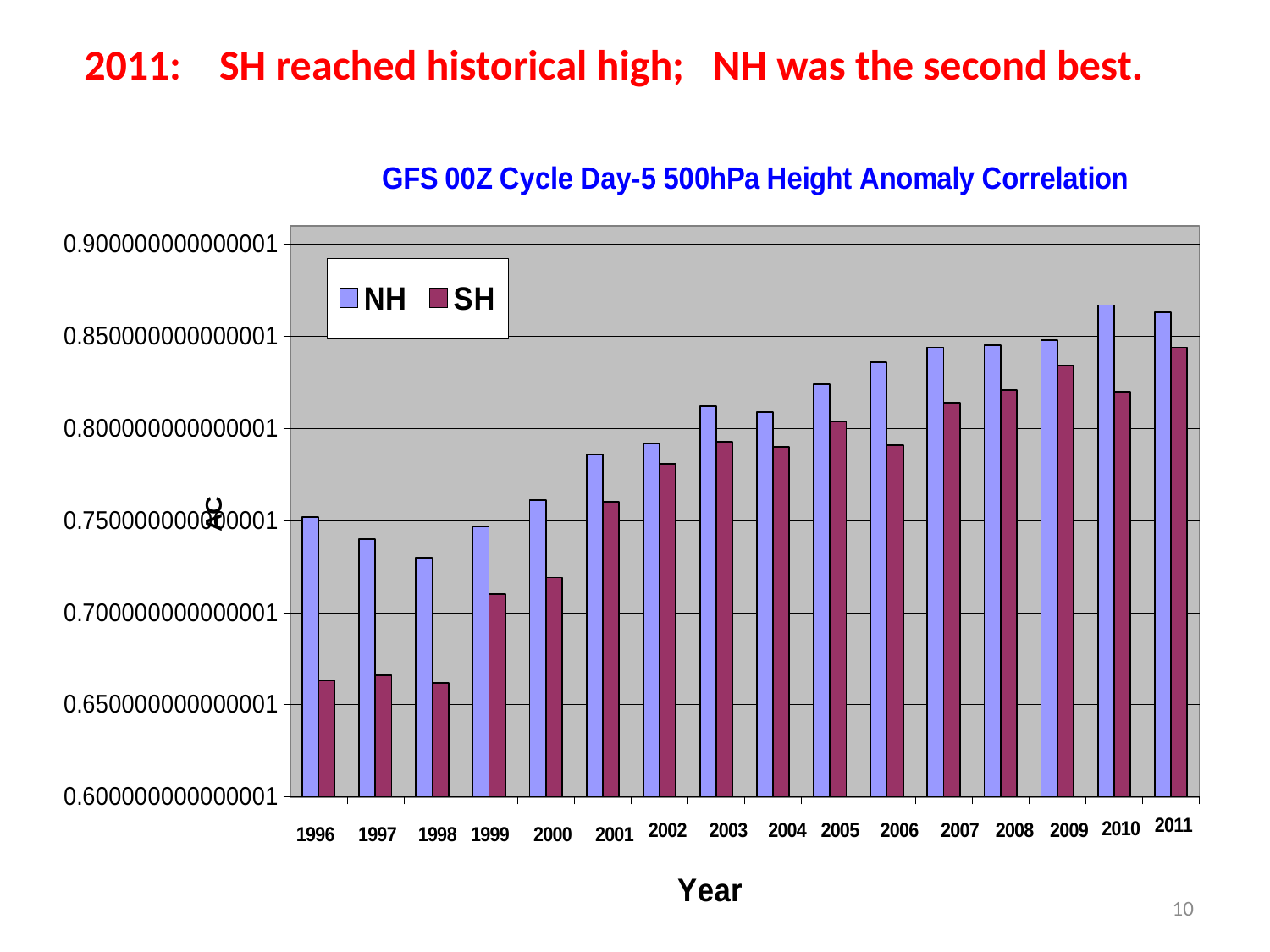
In which year is the NH value highest? 2010 In which year is the SH value highest? 2011 In 2006, which series has the larger value, NH or SH? NH What is the title of the chart? GFS 00Z Cycle Day-5 500hPa Height Anomaly Correlation How many years are shown along the x axis? 16 Do the SH values generally rise or fall from 1996 to 2011? rise In which year is the NH value lowest? 1998 Is the NH value for 1998 greater or less than 0.75? less Is the NH value for 2010 greater or less than 0.85? greater How many series does the legend list? 2 What kind of chart is shown on the slide? bar chart Is the SH value for 1996 greater or less than 0.70? less